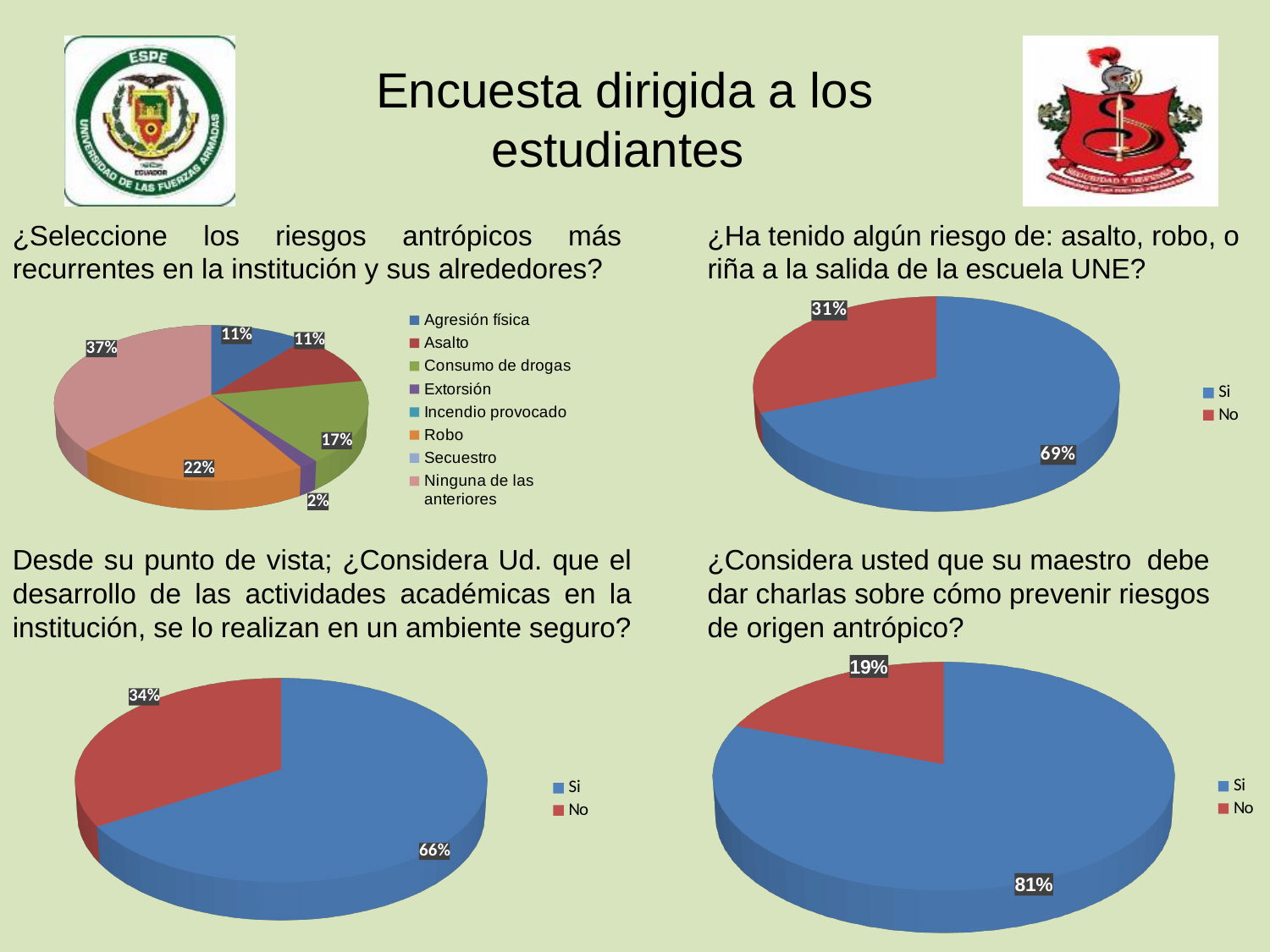
In the top-right pie chart about having suffered assault, robbery or a fight leaving the UNE school, what percentage answered 'Si'? 69% In the top-left pie chart about the most recurrent anthropic risks, how many entries does the legend list? 8 In the top-right pie chart about having suffered assault, robbery or a fight leaving the UNE school, what percentage answered 'No'? 31% In the top-left pie chart about the most recurrent anthropic risks, what share is labelled for 'Ninguna de las anteriores'? 37% In the top-left pie chart about the most recurrent anthropic risks, what share is labelled for 'Consumo de drogas'? 17% In the bottom-left pie chart about whether academic activities take place in a safe environment, what percentage answered 'No'? 34% In the bottom-right pie chart about whether the teacher should give talks on preventing anthropic risks, what percentage answered 'Si'? 81% What type of chart is used for the bottom-right chart about whether the teacher should give talks on preventing anthropic risks? Pie chart In the bottom-left pie chart about whether academic activities take place in a safe environment, which answer has the larger slice, 'Si' or 'No'? Si In the top-left pie chart about the most recurrent anthropic risks, what share is labelled for 'Robo'? 22% In the top-left pie chart about the most recurrent anthropic risks, which category has the largest slice? Ninguna de las anteriores In the top-left pie chart about the most recurrent anthropic risks, what is the difference between the 'Robo' share and the 'Consumo de drogas' share? 5%